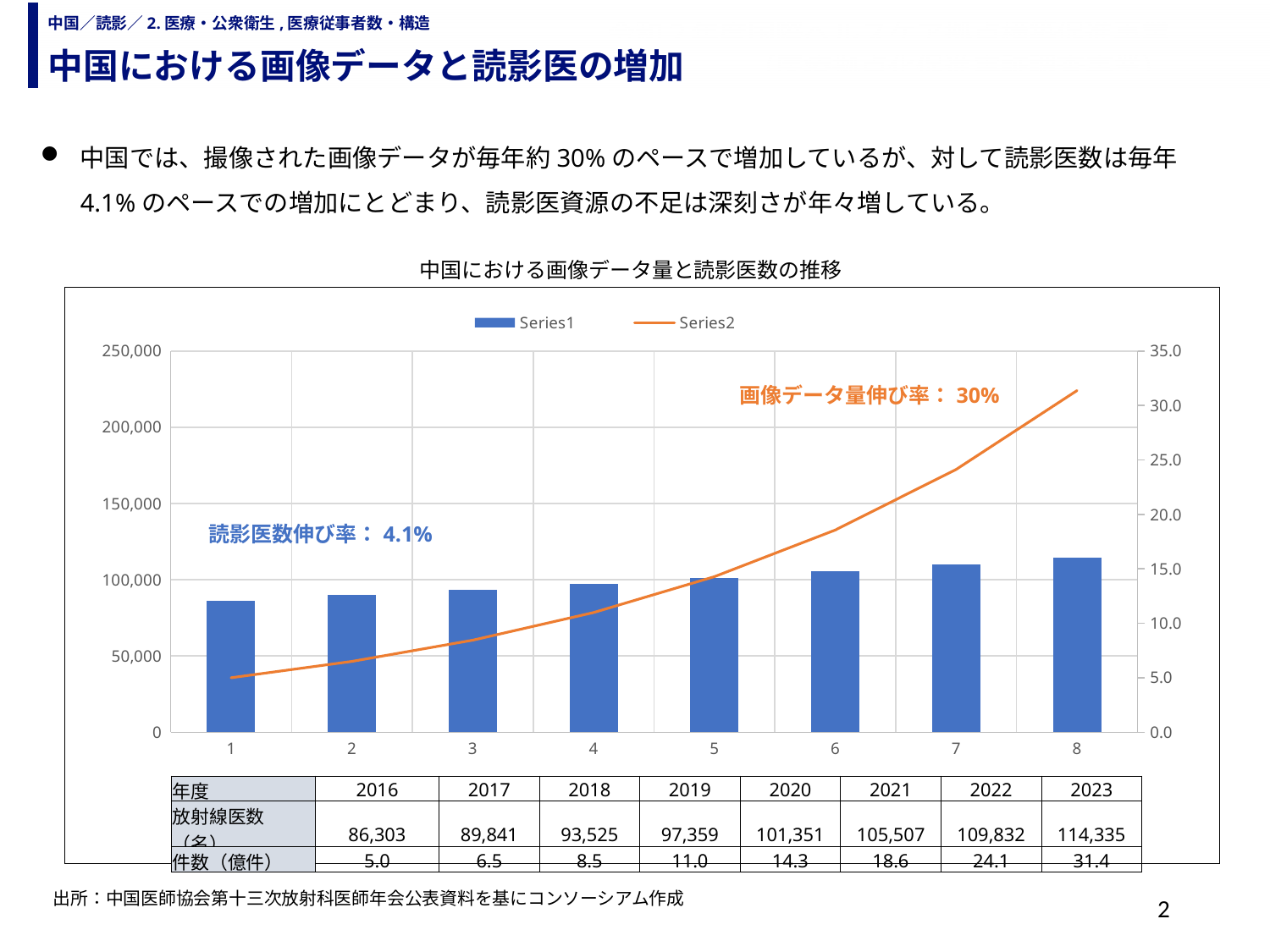
Which year has the lowest image data count (件数) in the chart? 2016 According to the data table under the chart, what is the number of radiologists (放射線医数) in 2016? 86,303 What growth rate for image data volume (画像データ量伸び率) is annotated on the chart? 30% What is the difference in the number of radiologists between 2023 and 2016 according to the data table? 28,032 How many years (categories) are shown along the x axis of the chart? 8 Do the bar values (Series1) rise or fall from left to right along the x axis? rise According to the data table under the chart, what is the image data count (件数, 億件) in 2020? 14.3 What is the title of the chart on the slide? 中国における画像データ量と読影医数の推移 Is the image data count (件数) larger in 2021 or in 2019? 2021 According to the data table under the chart, what is the number of radiologists (放射線医数) in 2023? 114,335 Which year has the highest number of radiologists (放射線医数) in the chart? 2023 How many series does the chart legend list? 2